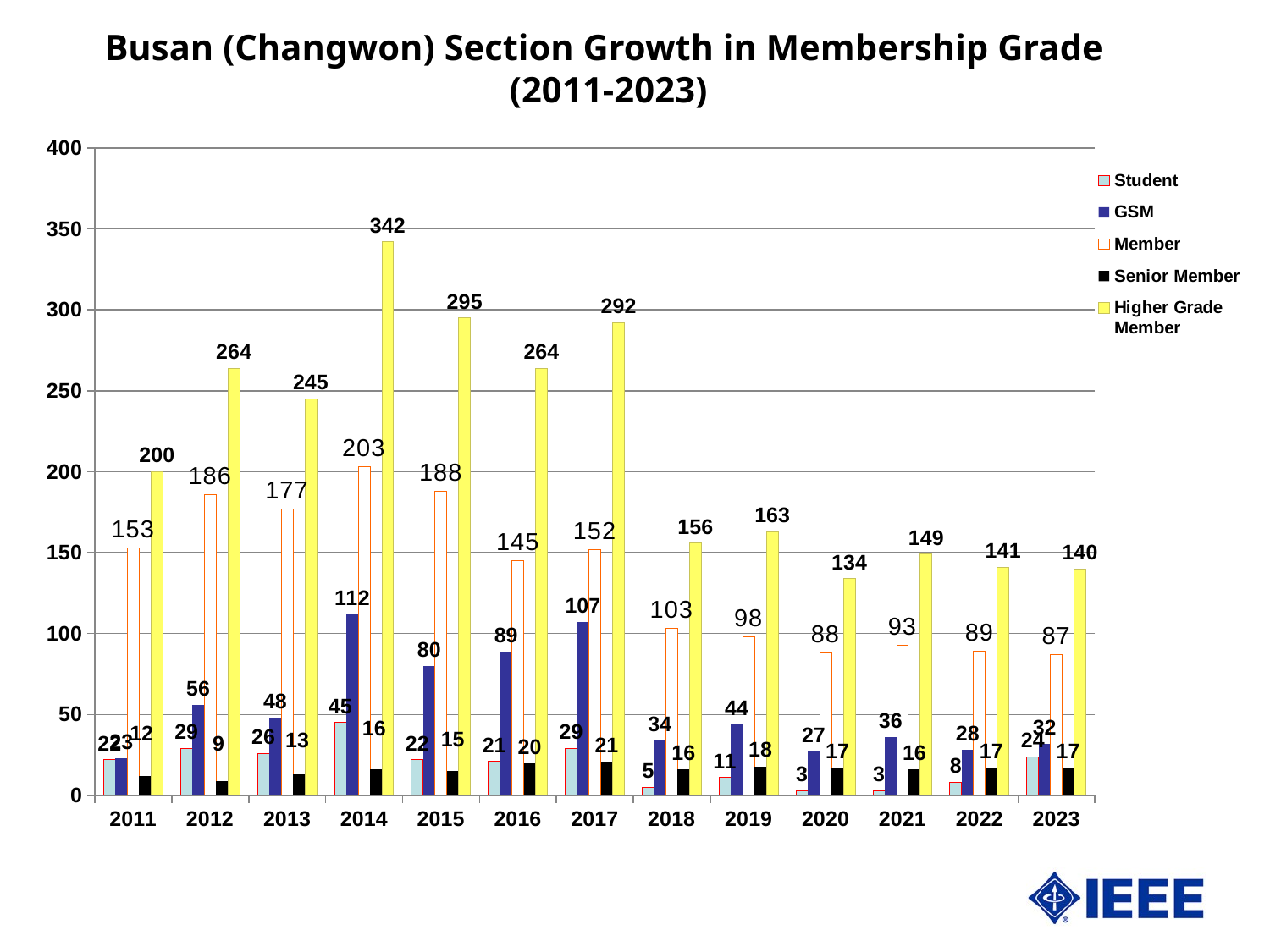
What is the difference between the Higher Grade Member values in 2014 and 2015? 47 What is the value for Member in 2018? 103 What is the value for Senior Member in 2016? 20 How many series does the legend list? 5 What kind of chart is shown on the slide? bar chart How many years are shown on the x axis? 13 What is the value for Higher Grade Member in 2014? 342 In which year is the Member value highest? 2014 Which year has the larger GSM value, 2014 or 2017? 2014 What is the value for GSM in 2017? 107 In which year is the Higher Grade Member value highest? 2014 In which year is the Higher Grade Member value lowest? 2020